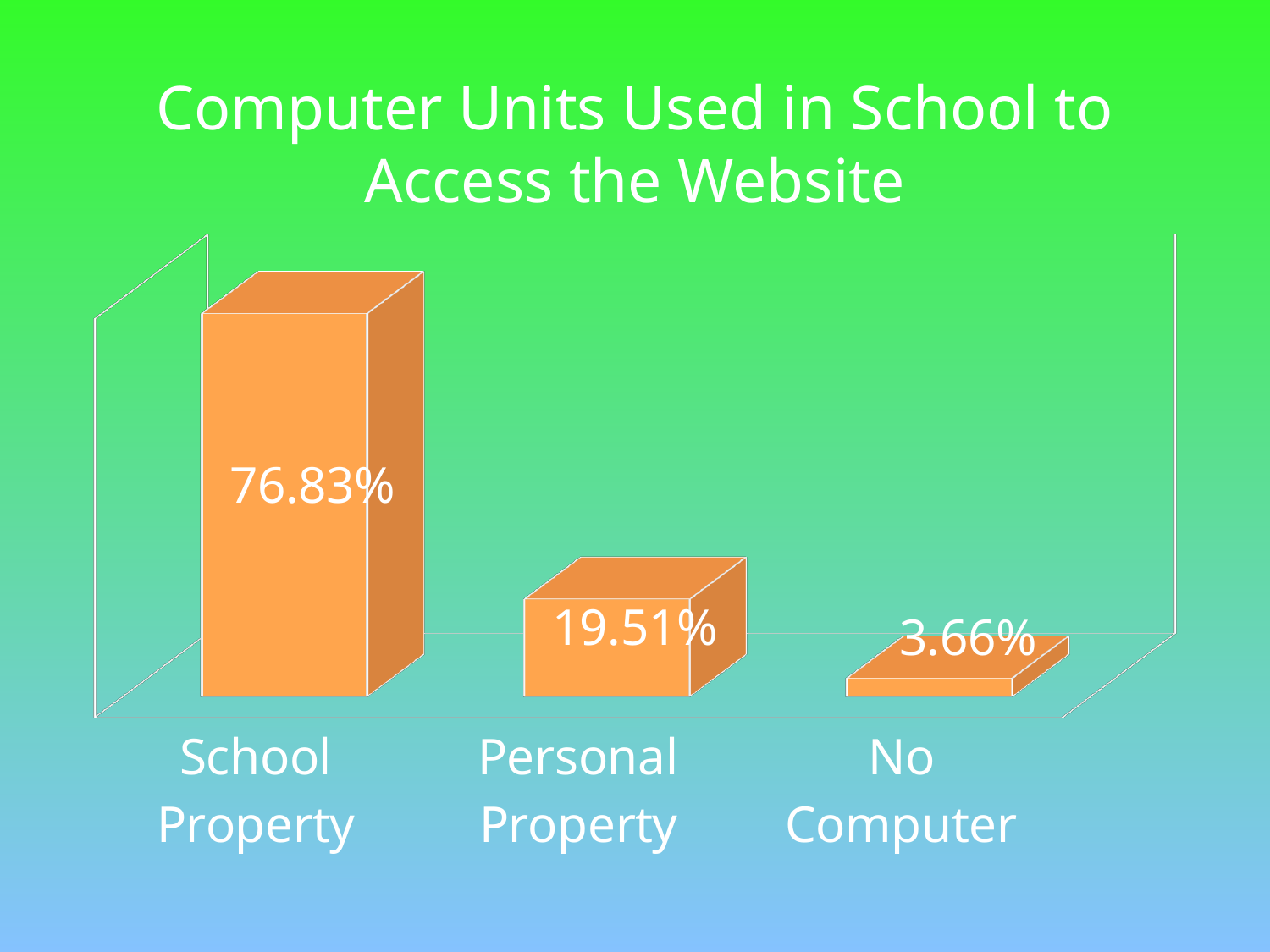
How many categories are shown in the chart? 3 What is the value for Personal Property? 19.51% What is the value for No Computer? 3.66% Which category has the lowest value? No Computer What is the difference between the values for Personal Property and No Computer? 15.85% What is the value for School Property? 76.83% Which category has the highest value? School Property What kind of chart is shown on the slide? Bar chart Do the values rise or fall from left to right across the categories? Fall What is the difference between the values for School Property and Personal Property? 57.32% What is the title of the chart? Computer Units Used in School to Access the Website Which is larger, the value for Personal Property or the value for No Computer? Personal Property